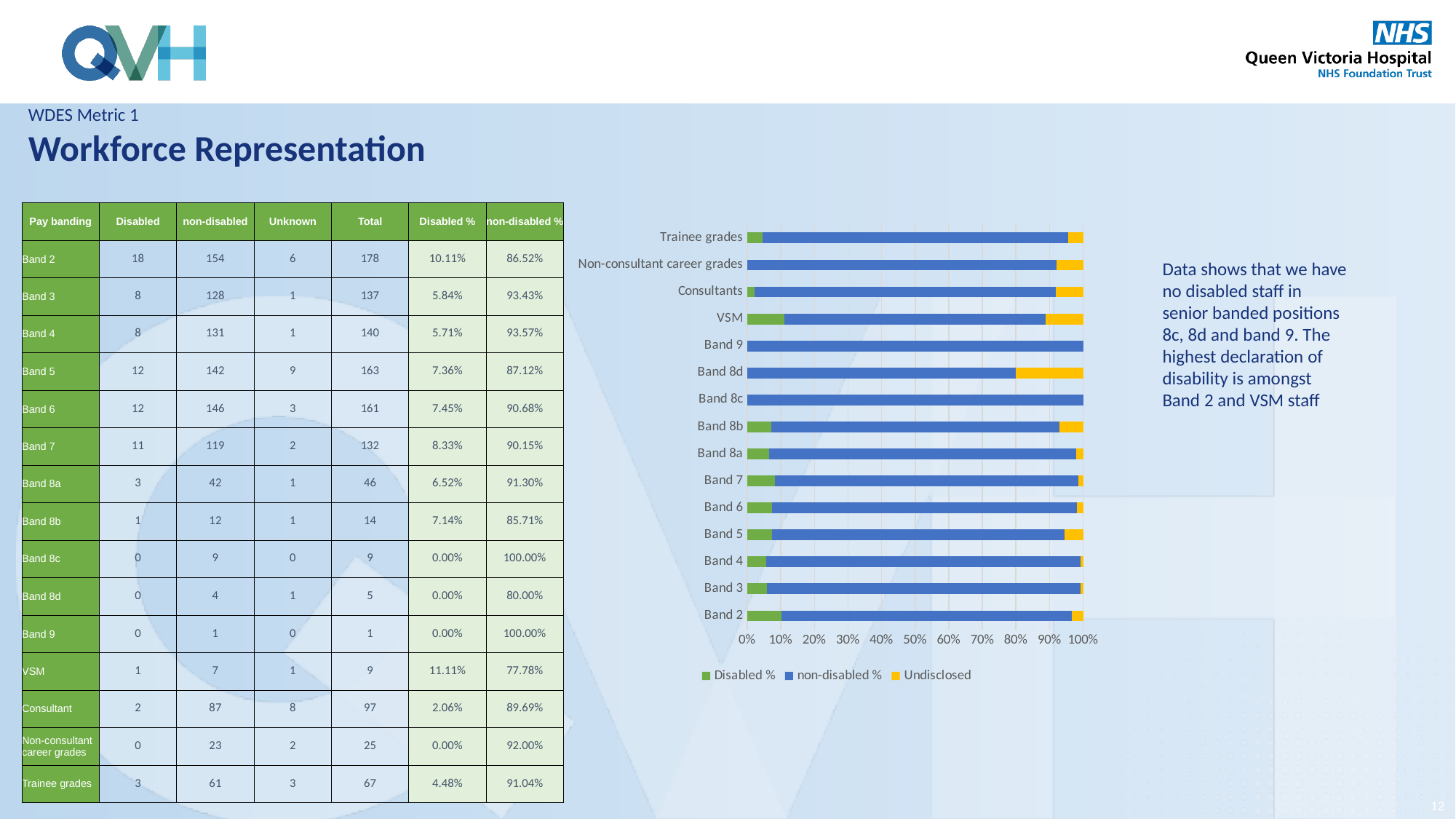
Is the non-disabled % for Band 9 greater or less than 90%? greater Is the Undisclosed share for Band 8d greater or less than 10%? greater How many series does the chart legend list? 3 Which has the larger Disabled %, VSM or Consultants? VSM How many pay banding categories are plotted on the chart? 15 Is the non-disabled % for Band 8d greater or less than 90%? less What is the Disabled % for Band 2? 10.11% What kind of chart is shown on the slide? Stacked bar chart Which series is shown in green on the chart? Disabled % What is the non-disabled % for VSM? 77.78% Which series is shown in yellow on the chart? Undisclosed Which has the larger Disabled %, Band 2 or Band 3? Band 2